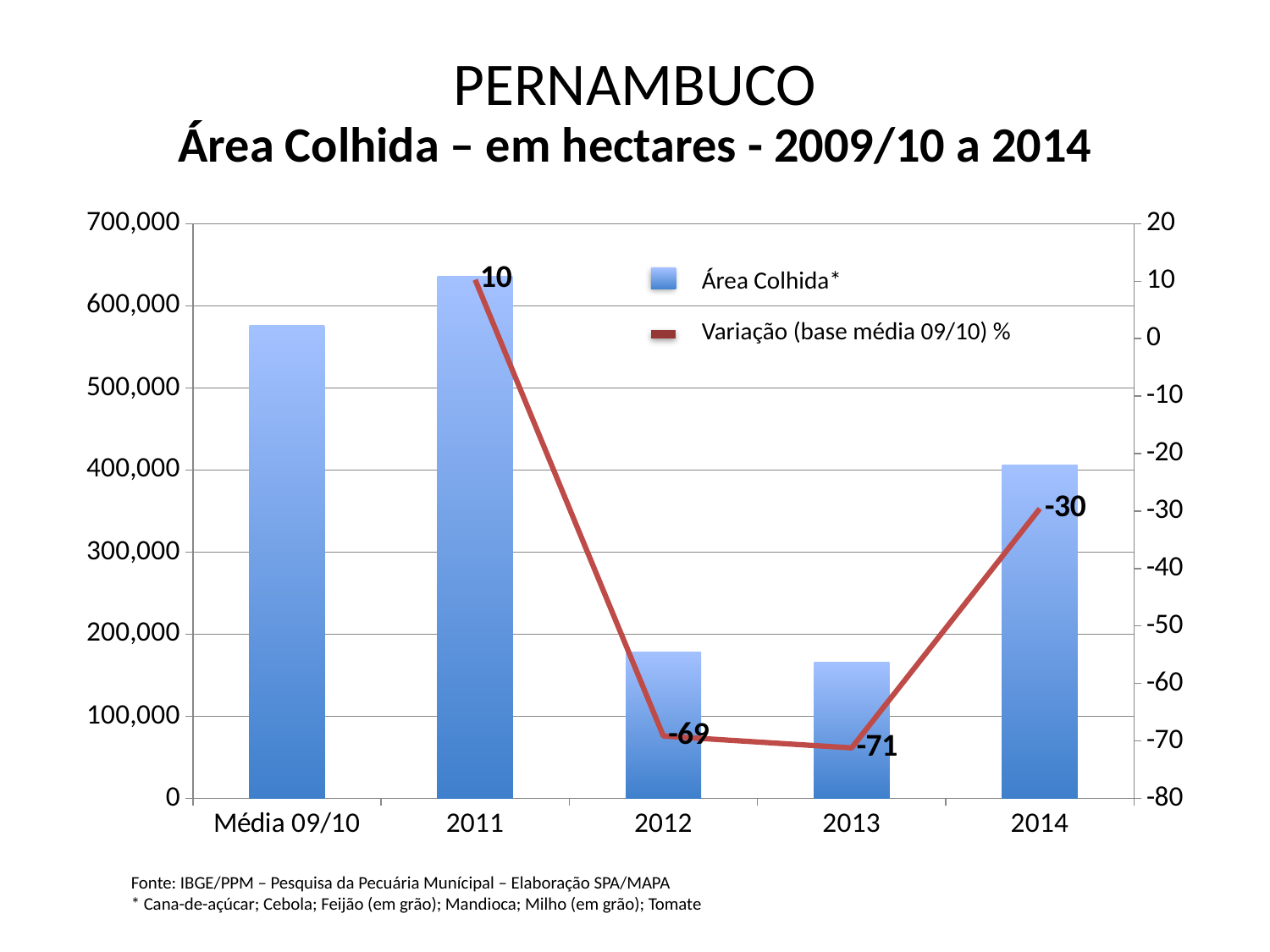
How many categories are shown on the x axis? 5 Which year has the lowest Área Colhida bar? 2013 Is the Área Colhida value for 2012 greater or less than 200,000? less Is the Área Colhida value for Média 09/10 greater or less than 500,000? greater What is the value of Variação (base média 09/10) % for 2014? -30 Which is larger, the Área Colhida bar for 2011 or for 2014? 2011 What is the value of Variação (base média 09/10) % for 2013? -71 How many series does the legend list? 2 What is the difference between the Variação values for 2011 and 2013? 81 What is the value of Variação (base média 09/10) % for 2011? 10 Does the Variação line rise or fall from 2011 to 2013? fall Which year has the highest Área Colhida bar? 2011